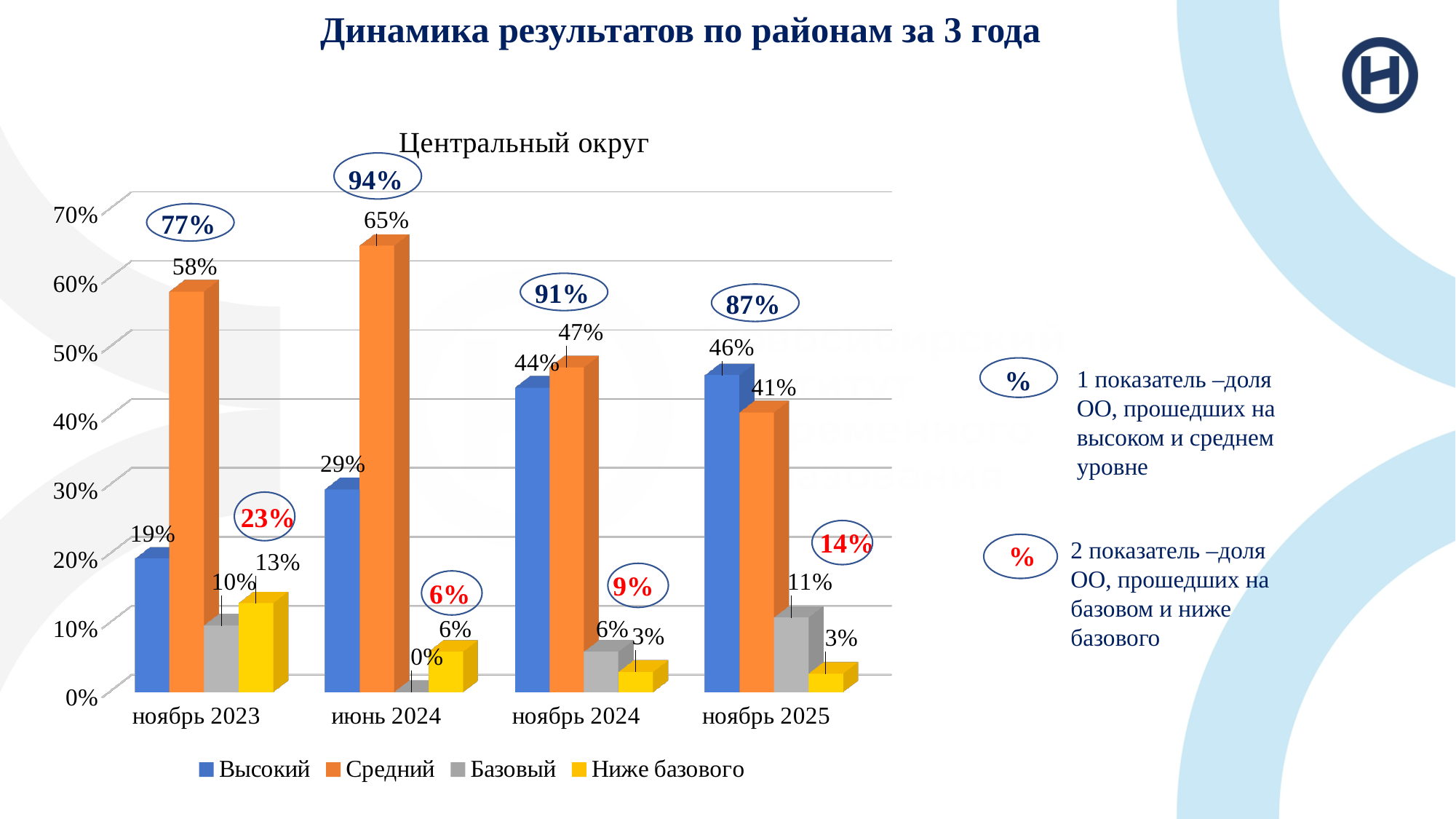
How many series does the legend list? 4 What is the value for Ниже базового in ноябрь 2024? 3% What is the difference between Средний and Высокий in ноябрь 2023? 39% What is the value for Базовый in ноябрь 2025? 11% Does the Высокий series rise or fall from ноябрь 2023 to ноябрь 2025? rise What is the value for Высокий in июнь 2024? 29% What is the value for Средний in ноябрь 2023? 58% In which period is the Высокий series lowest? ноябрь 2023 What kind of chart is shown? bar chart Which is larger in ноябрь 2025, Высокий or Средний? Высокий In which period is the Средний series highest? июнь 2024 How many periods are shown on the x axis? 4